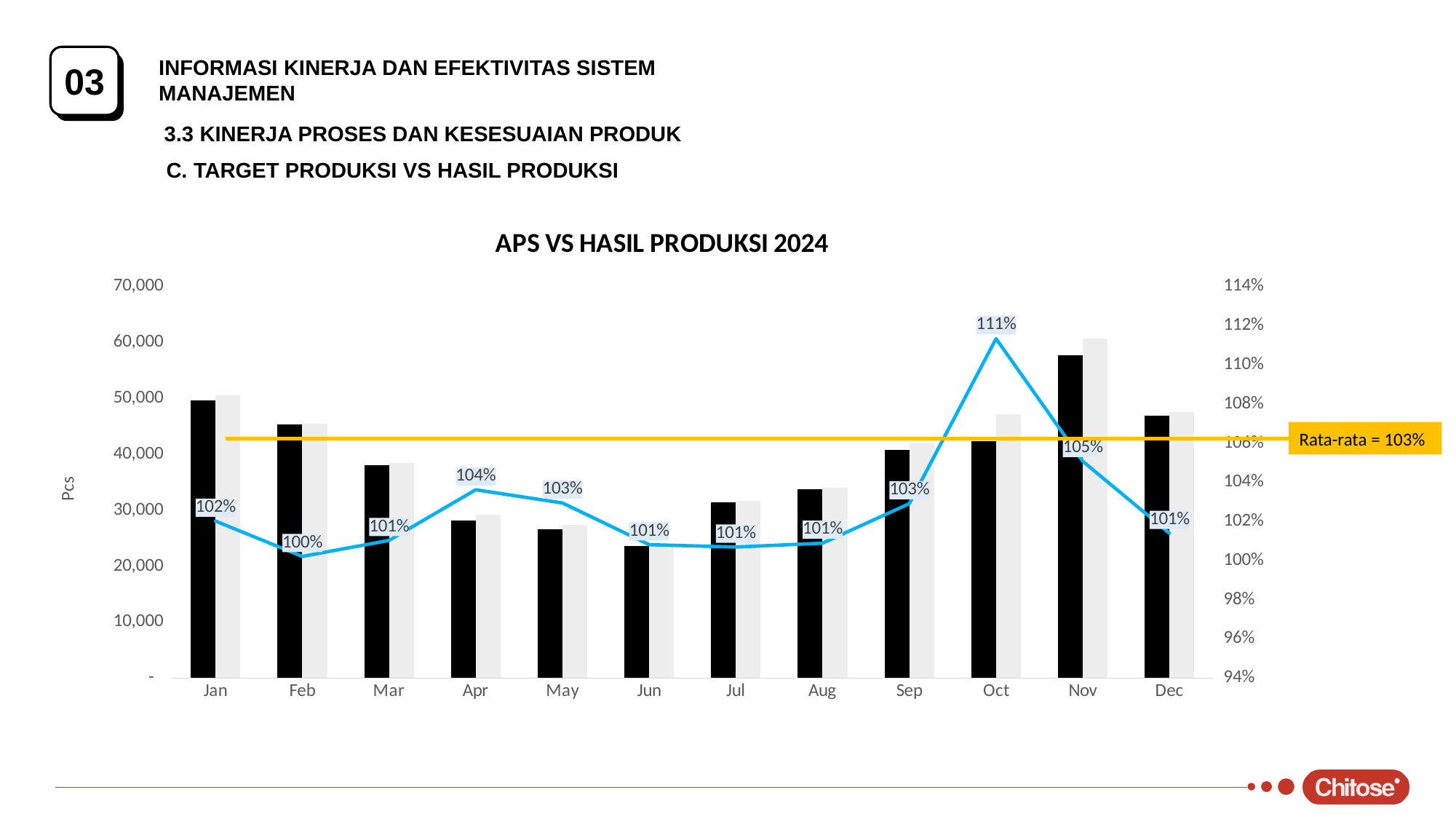
What percentage value is shown on the line for Apr? 104% Which month has the lowest percentage value on the line? Feb What kind of chart is this? Combined bar and line chart What percentage value is shown on the line for Feb? 100% Which month has the highest percentage value on the line? Oct Is the black bar for Jun greater or less than 30,000? less What average value (Rata-rata) is indicated by the yellow horizontal line? 103% Which month has a higher percentage value on the line, Nov or Sep? Nov What percentage value is shown on the line for Oct? 111% How many months are shown on the x axis? 12 What is the title of the chart? APS VS HASIL PRODUKSI 2024 What is the difference in percentage points between the line values for Oct and Feb? 11 percentage points